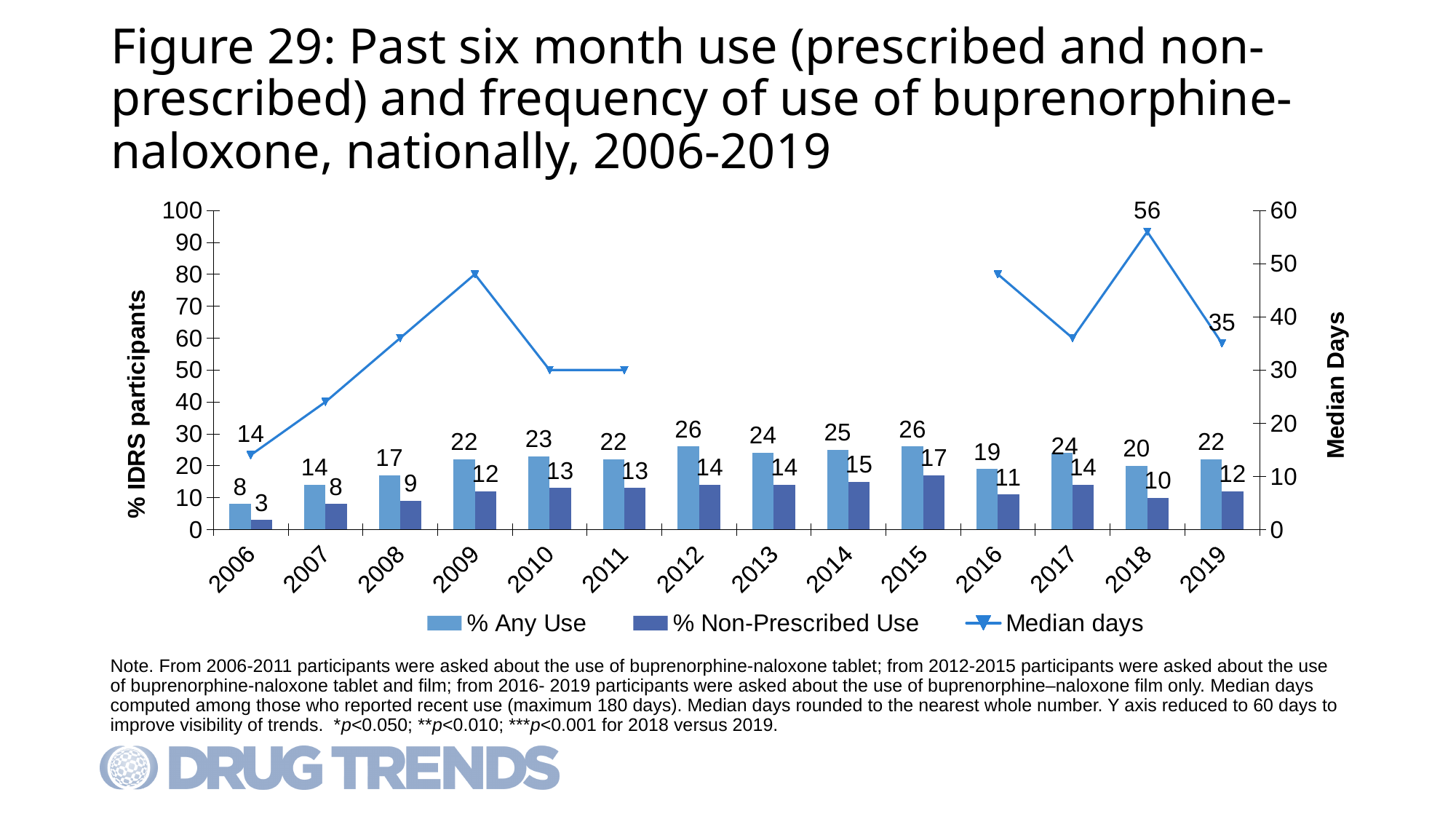
What is the % Any Use value for 2012? 26 What is the % Non-Prescribed Use value for 2015? 17 What is the difference between % Any Use and % Non-Prescribed Use in 2019? 10 What is the Median days value for 2018? 56 What is the Median days value for 2019? 35 Which is larger, the % Any Use value for 2014 or for 2016? 2014 Which year has the highest % Non-Prescribed Use value? 2015 Which year has the highest Median days value? 2018 Is the Median days value for 2009 greater or less than 40? greater How many years are shown on the x axis? 14 Which year has the lowest % Any Use value? 2006 How many series does the legend list? 3